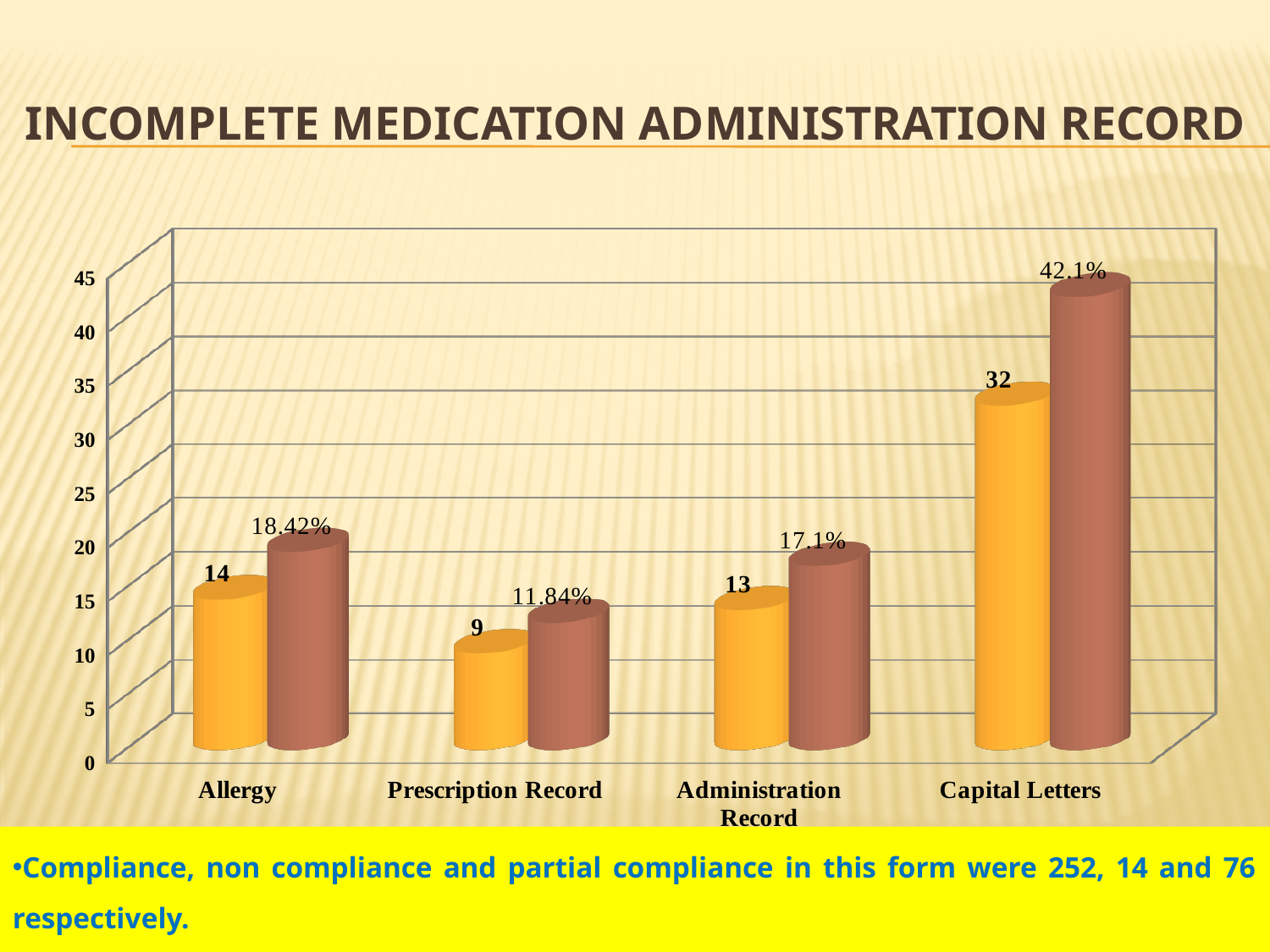
What is the value of the orange bar for Prescription Record? 9 What is the difference between the orange bar values for Capital Letters and Allergy? 18 What percentage is shown on the brown bar for Administration Record? 17.1% Which category has the highest orange bar? Capital Letters Which has a larger orange bar value, Allergy or Administration Record? Allergy How many categories are shown on the x axis? 4 What is the value of the orange bar for Allergy? 14 What percentage is shown on the brown bar for Capital Letters? 42.1% Which category has the lowest brown (percentage) bar? Prescription Record What kind of chart is shown on the slide? Bar chart Is the brown bar value for Capital Letters greater or less than 40? greater What is the title of the slide containing the chart? INCOMPLETE MEDICATION ADMINISTRATION RECORD